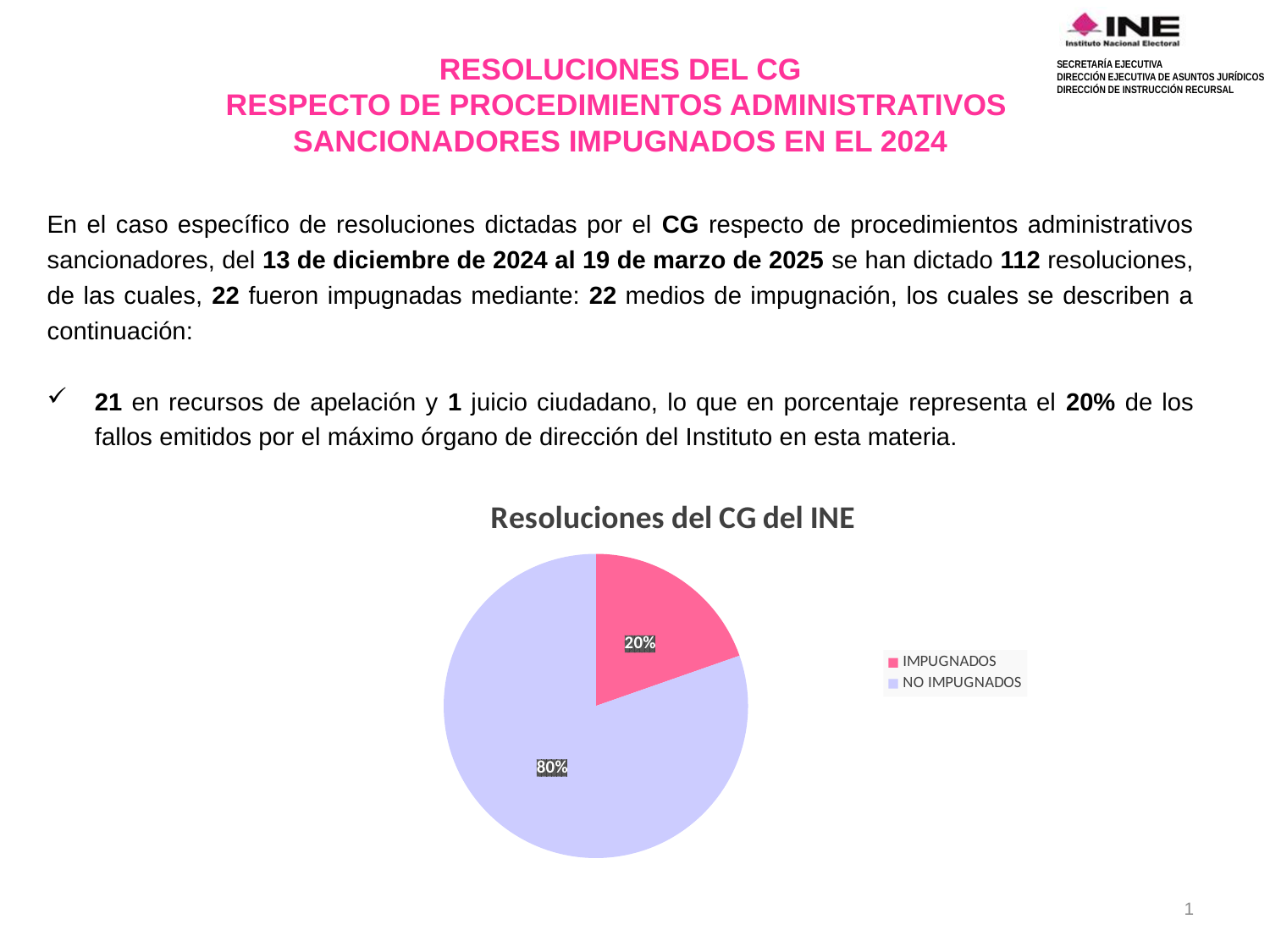
Which slice of the pie is the largest? NO IMPUGNADOS What share of the pie is labelled IMPUGNADOS? 20% Which slice of the pie is the smallest? IMPUGNADOS How many slices does the pie chart have? 2 What share of the pie is labelled NO IMPUGNADOS? 80% Which is larger, the IMPUGNADOS slice or the NO IMPUGNADOS slice? NO IMPUGNADOS What is the title of the chart? Resoluciones del CG del INE How many entries does the legend list? 2 What kind of chart is shown on the slide? pie chart What is the difference in percentage points between the NO IMPUGNADOS slice and the IMPUGNADOS slice? 60 percentage points What colour is the IMPUGNADOS slice in the pie chart? pink